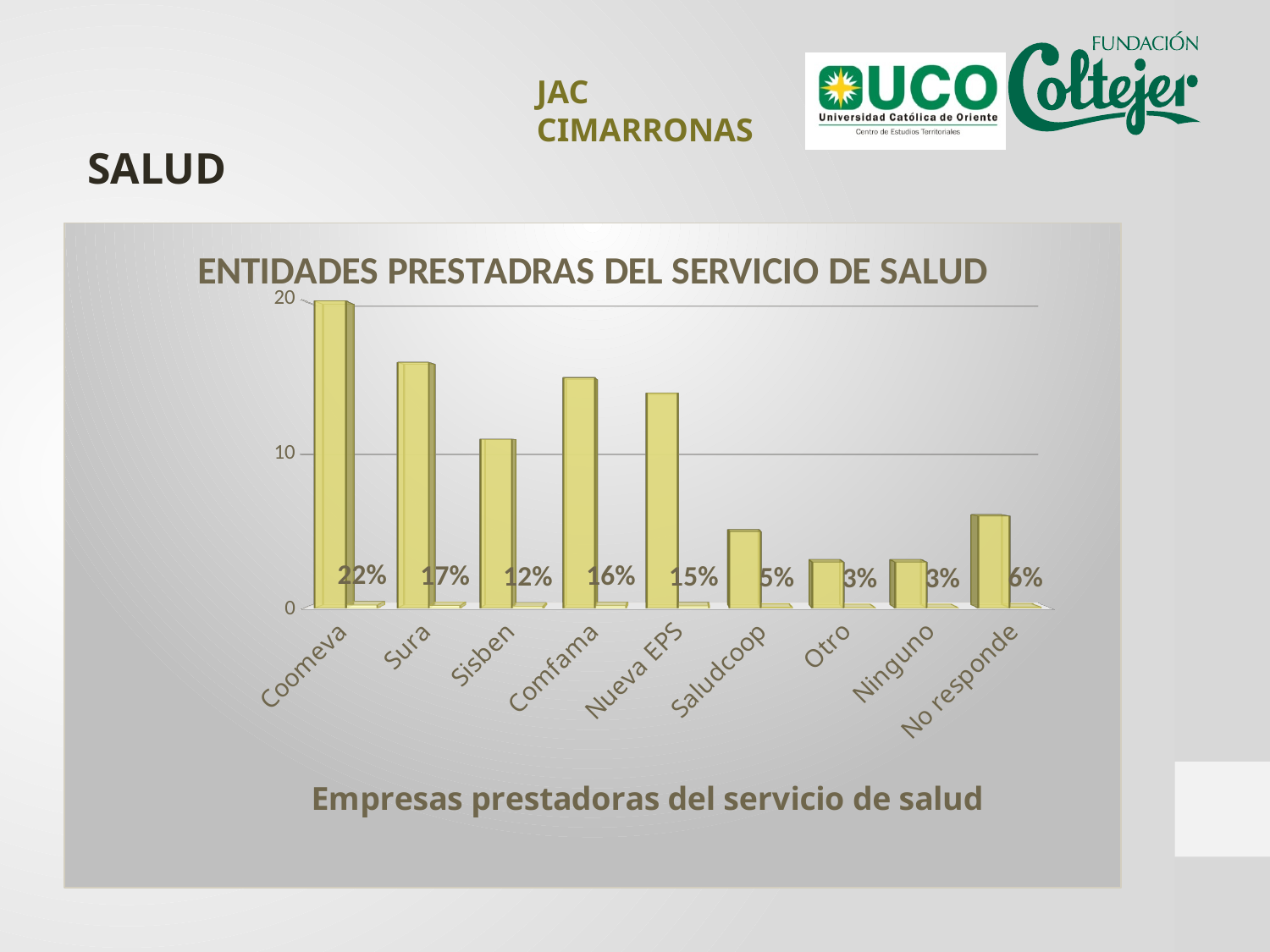
What is the value shown for No responde? 6% What kind of chart is shown on the slide? Bar chart Which has a larger value, Comfama or Nueva EPS? Comfama Is the bar for Sisben greater or less than 10 on the vertical axis? greater Which category has the highest value? Coomeva What is the value shown for Coomeva? 22% What is the value shown for Saludcoop? 5% What is the difference between the values for Coomeva and Sura? 5% What is the title of the chart? ENTIDADES PRESTADRAS DEL SERVICIO DE SALUD What is the value shown for Sura? 17% How many categories are shown on the x axis? 9 Is the bar for Otro greater or less than 10 on the vertical axis? less